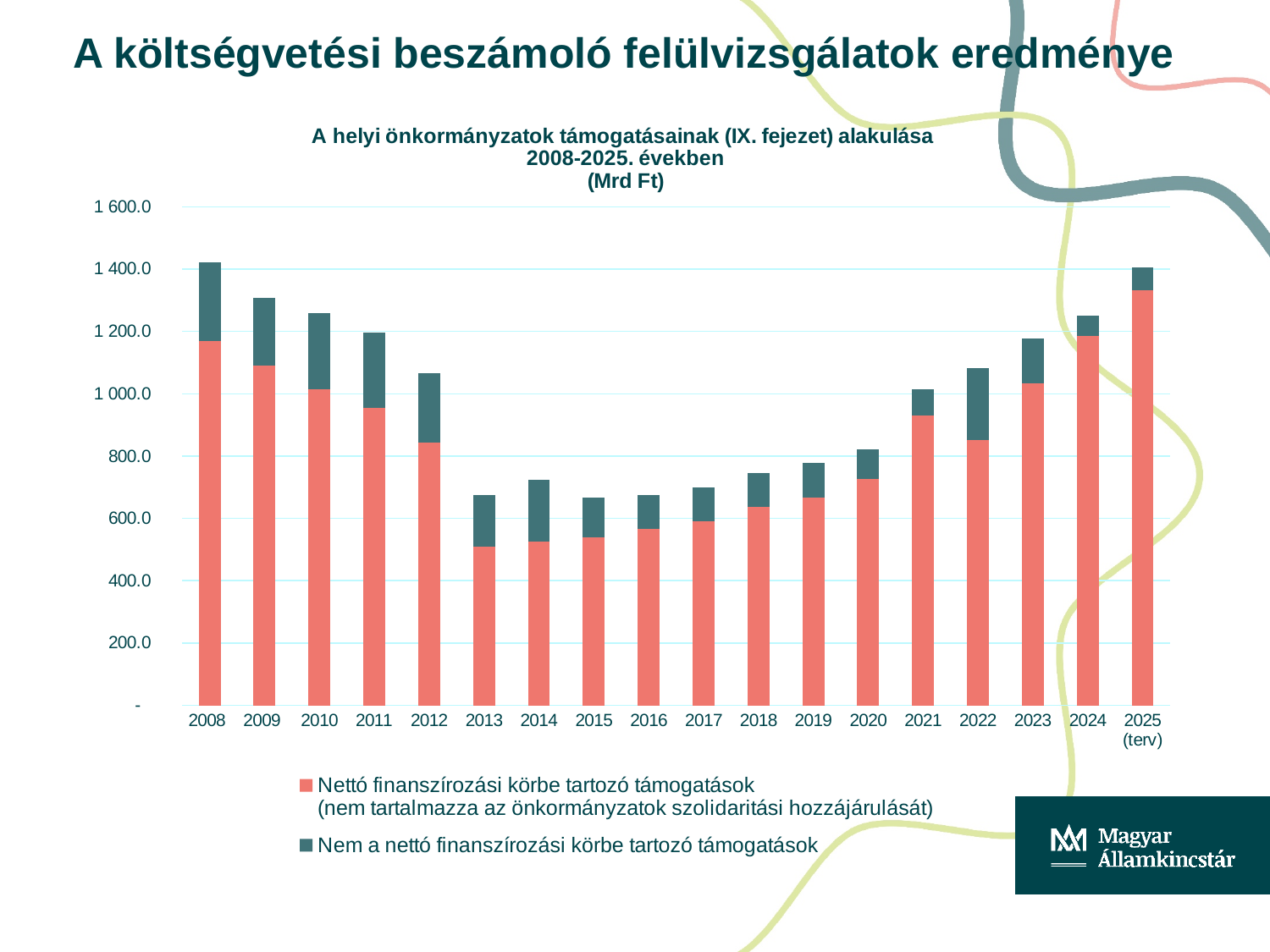
How many series does the chart's legend list? 2 How many years are shown on the x axis of the chart? 18 Do the total values of the bars rise or fall from 2008 to 2013? fall What kind of chart is shown on the slide? bar chart Which year has the highest value for the 'Nettó finanszírozási körbe tartozó támogatások' series? 2025 (terv) Is the total value of the stacked bar for 2013 greater or less than 800.0? less What unit is given in the chart title? Mrd Ft Which stacked bar is taller, 2012 or 2020? 2012 Is the total value of the stacked bar for 2022 greater or less than 1 000.0? greater Is the total value of the stacked bar for 2015 greater or less than 800.0? less